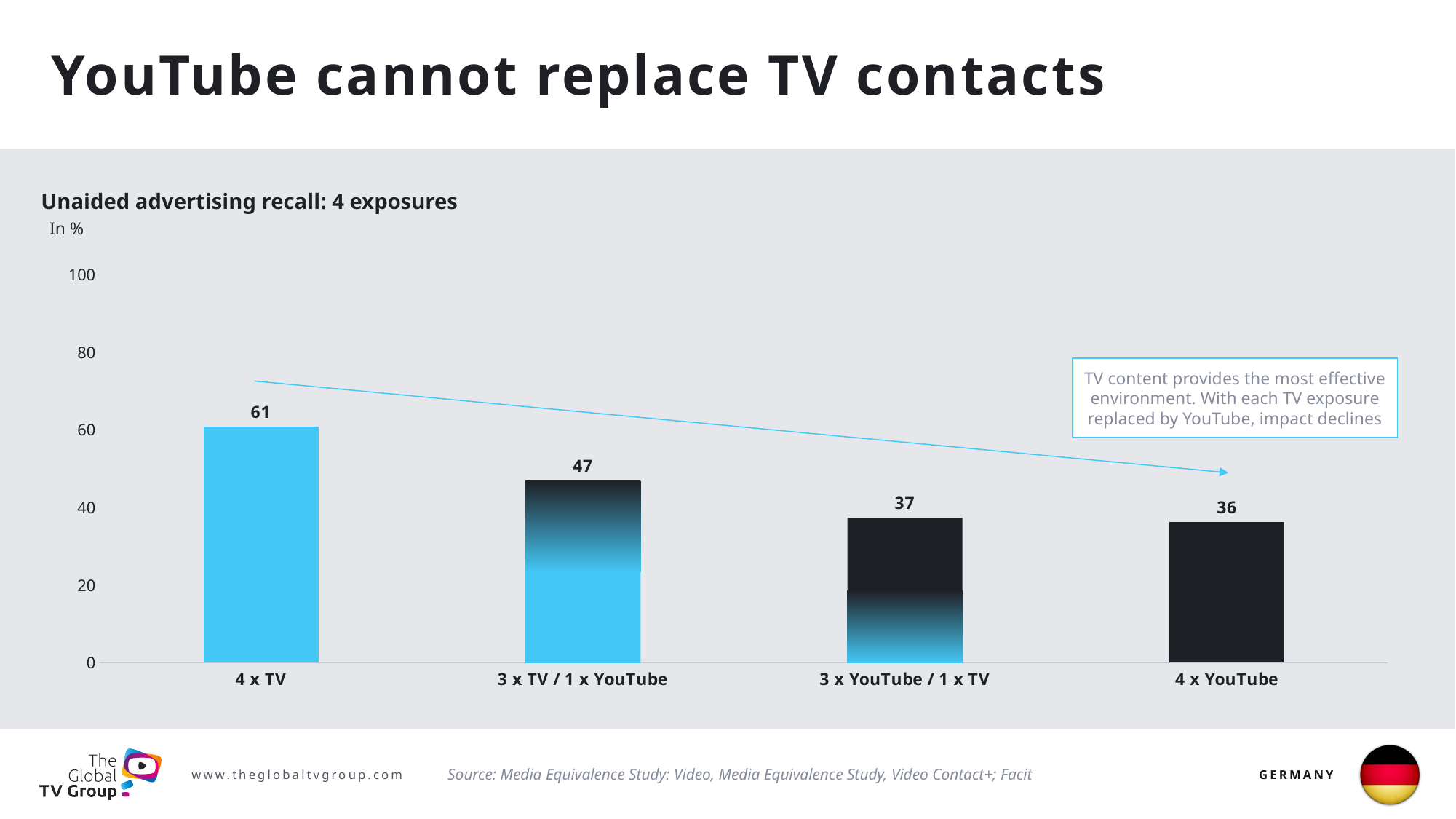
What is the unaided advertising recall value for 4 x TV? 61 What kind of chart is shown on the slide? Bar chart Do the values rise or fall from left to right along the x axis? Fall What is the difference between the values for 3 x TV / 1 x YouTube and 3 x YouTube / 1 x TV? 10 Which category has the lowest unaided advertising recall? 4 x YouTube Which is larger, the value for 4 x TV or the value for 3 x TV / 1 x YouTube? 4 x TV How many categories are shown on the x axis of the chart? 4 Which category has the highest unaided advertising recall? 4 x TV What is the value shown for 3 x TV / 1 x YouTube? 47 What is the difference between the values for 4 x TV and 4 x YouTube? 25 What is the value shown for 4 x YouTube? 36 What is the value shown for 3 x YouTube / 1 x TV? 37